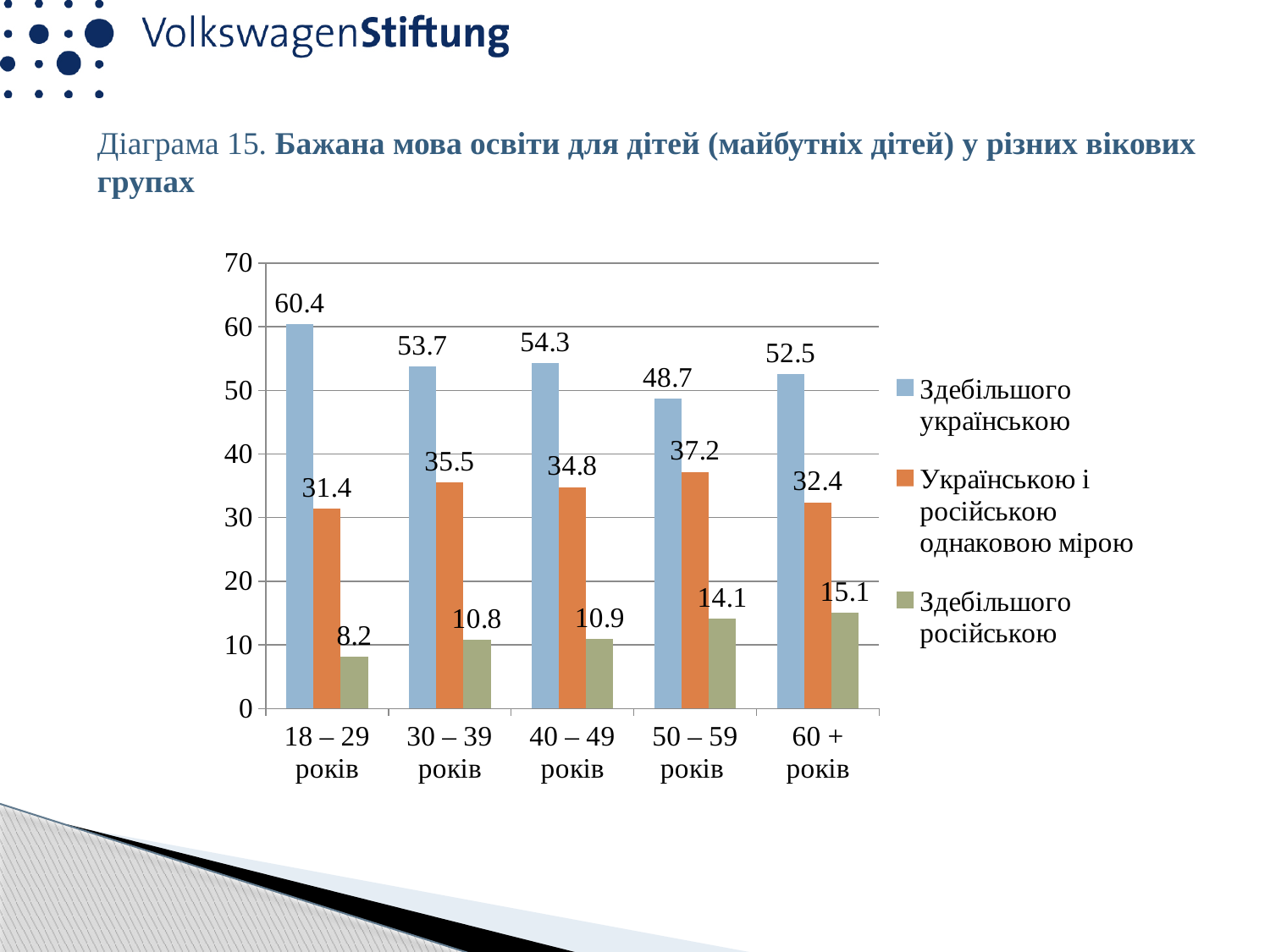
What is the difference between the 'Здебільшого українською' values for 18 – 29 років and 50 – 59 років? 11.7 Does the value for 'Здебільшого російською' rise or fall from 18 – 29 років to 60 + років? rise How many series does the legend list? 3 What is the value for 'Здебільшого російською' in the 50 – 59 років age group? 14.1 What is the value for 'Здебільшого українською' in the 18 – 29 років age group? 60.4 Which age group has the lowest value for 'Здебільшого російською'? 18 – 29 років Which is larger: 'Українською і російською однаковою мірою' for 50 – 59 років or for 60 + років? 50 – 59 років How many age groups are shown on the x axis? 5 What kind of chart is shown on the slide? bar chart What is the value for 'Українською і російською однаковою мірою' in the 30 – 39 років age group? 35.5 Which age group has the highest value for 'Здебільшого українською'? 18 – 29 років Is the value for 'Здебільшого українською' in the 50 – 59 років group greater or less than 50? less